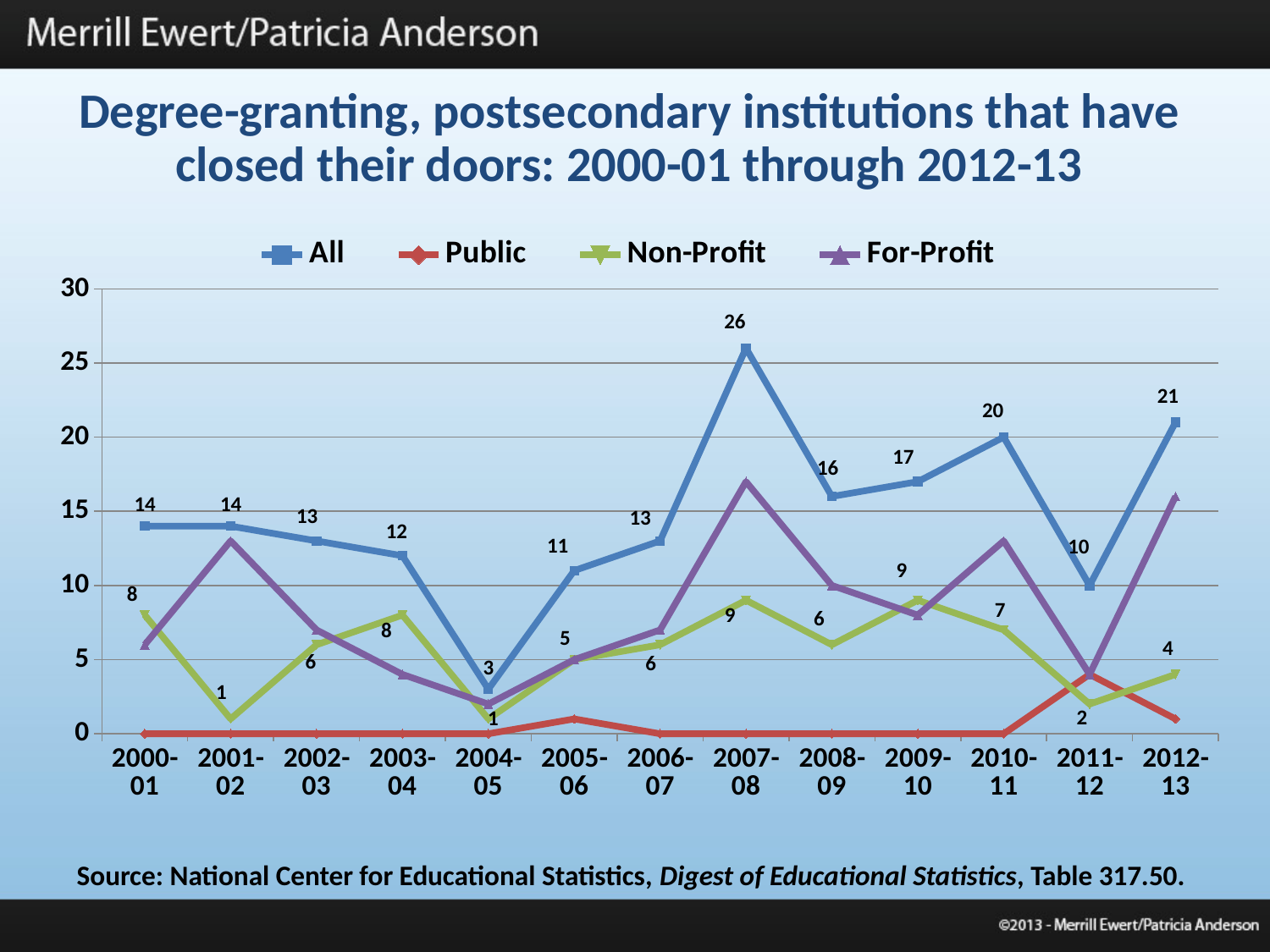
In which year does the All series reach its lowest value? 2004-05 Does the All series rise or fall from 2010-11 to 2011-12? fall What is the value for the Non-Profit series in 2011-12? 2 Is the For-Profit value in 2007-08 greater or less than 15? greater In which year does the All series reach its highest value? 2007-08 How many series does the legend list? 4 What type of chart is shown on the slide? line chart Which series is drawn in red? Public What is the value for the All series in 2007-08? 26 How many academic years are plotted along the x axis? 13 What is the difference between the All value in 2012-13 and the All value in 2011-12? 11 Which is larger, the Non-Profit value in 2009-10 or the Non-Profit value in 2010-11? 2009-10